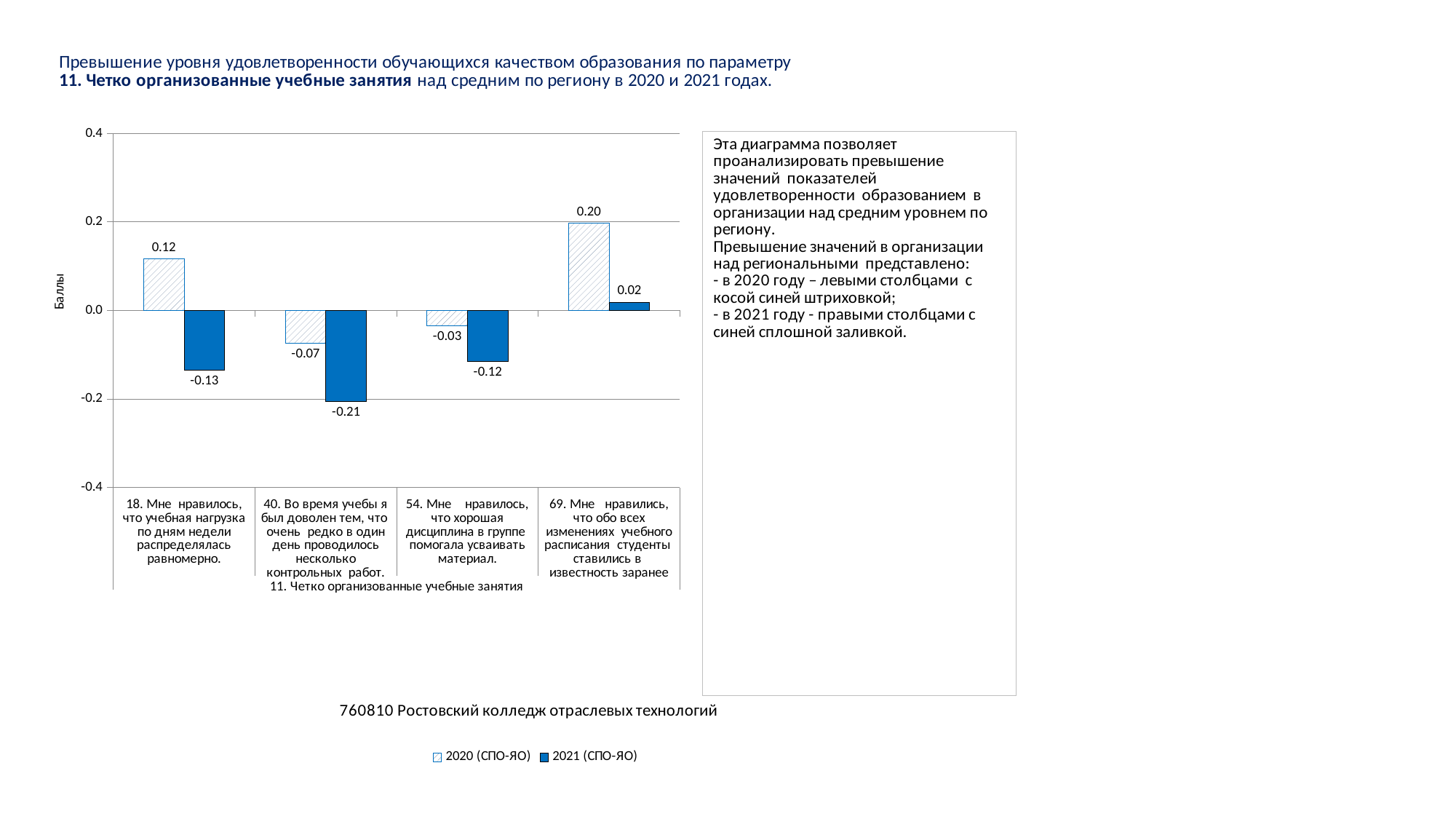
What is the 2020 (СПО-ЯО) value for category "18. Мне нравилось, что учебная нагрузка по дням недели распределялась равномерно."? 0.12 What is the 2021 (СПО-ЯО) value for category "69. Мне нравились, что обо всех изменениях учебного расписания студенты ставились в известность заранее"? 0.02 What is the difference between the 2020 and 2021 values for category "18. Мне нравилось, что учебная нагрузка по дням недели распределялась равномерно."? 0.25 Which category has the highest 2020 (СПО-ЯО) value? 69. Мне нравились, что обо всех изменениях учебного расписания студенты ставились в известность заранее What kind of chart is shown on the slide? Bar chart What is the label of the vertical axis of the chart? Баллы How many categories are shown on the x axis of the chart? 4 Which category has the lowest 2021 (СПО-ЯО) value? 40. Во время учебы я был доволен тем, что очень редко в один день проводилось несколько контрольных работ. For category "54. Мне нравилось, что хорошая дисциплина в группе помогала усваивать материал.", which series has the larger value, 2020 (СПО-ЯО) or 2021 (СПО-ЯО)? 2020 (СПО-ЯО) What is the 2020 (СПО-ЯО) value for category "54. Мне нравилось, что хорошая дисциплина в группе помогала усваивать материал."? -0.03 What is the 2021 (СПО-ЯО) value for category "40. Во время учебы я был доволен тем, что очень редко в один день проводилось несколько контрольных работ."? -0.21 How many series does the chart legend list? 2